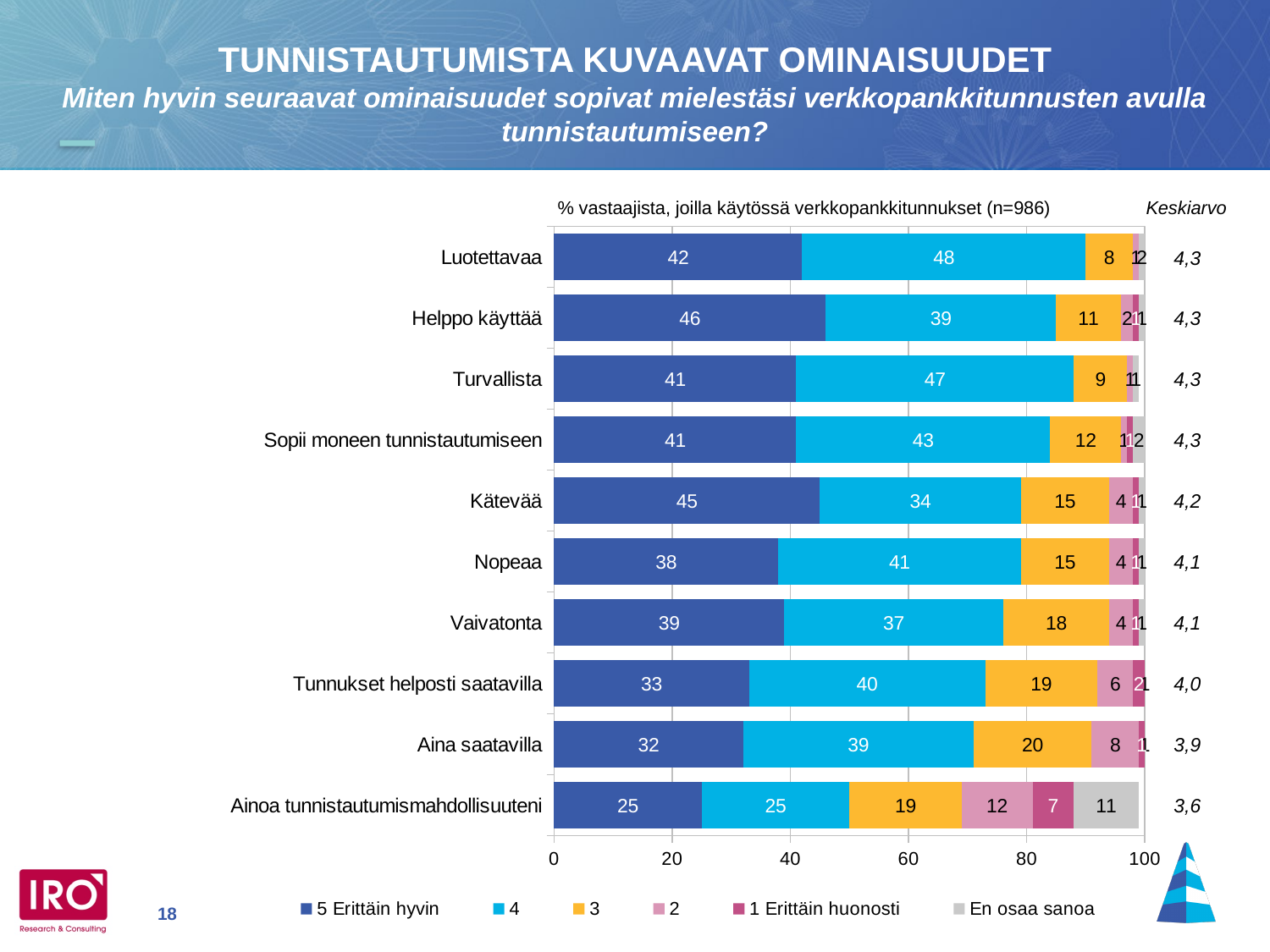
What is the "En osaa sanoa" value for "Ainoa tunnistautumismahdollisuuteni"? 11 What is the value of the "3" segment for "Aina saatavilla"? 20 How many categories (attributes) are shown in the chart? 10 Which category has the highest "5 Erittäin hyvin" value? Helppo käyttää What is the "1 Erittäin huonosti" value for "Ainoa tunnistautumismahdollisuuteni"? 7 Which has a larger "3" value: "Vaivatonta" or "Tunnukset helposti saatavilla"? Tunnukset helposti saatavilla What kind of chart is shown on the slide? Stacked bar chart What percentage of respondents rated "Helppo käyttää" as "5 Erittäin hyvin"? 46 Which category has the lowest "5 Erittäin hyvin" value? Ainoa tunnistautumismahdollisuuteni What is the value of the "4" segment for "Luotettavaa"? 48 What is the difference between the "5 Erittäin hyvin" values for "Kätevää" and "Nopeaa"? 7 How many series does the legend list? 6